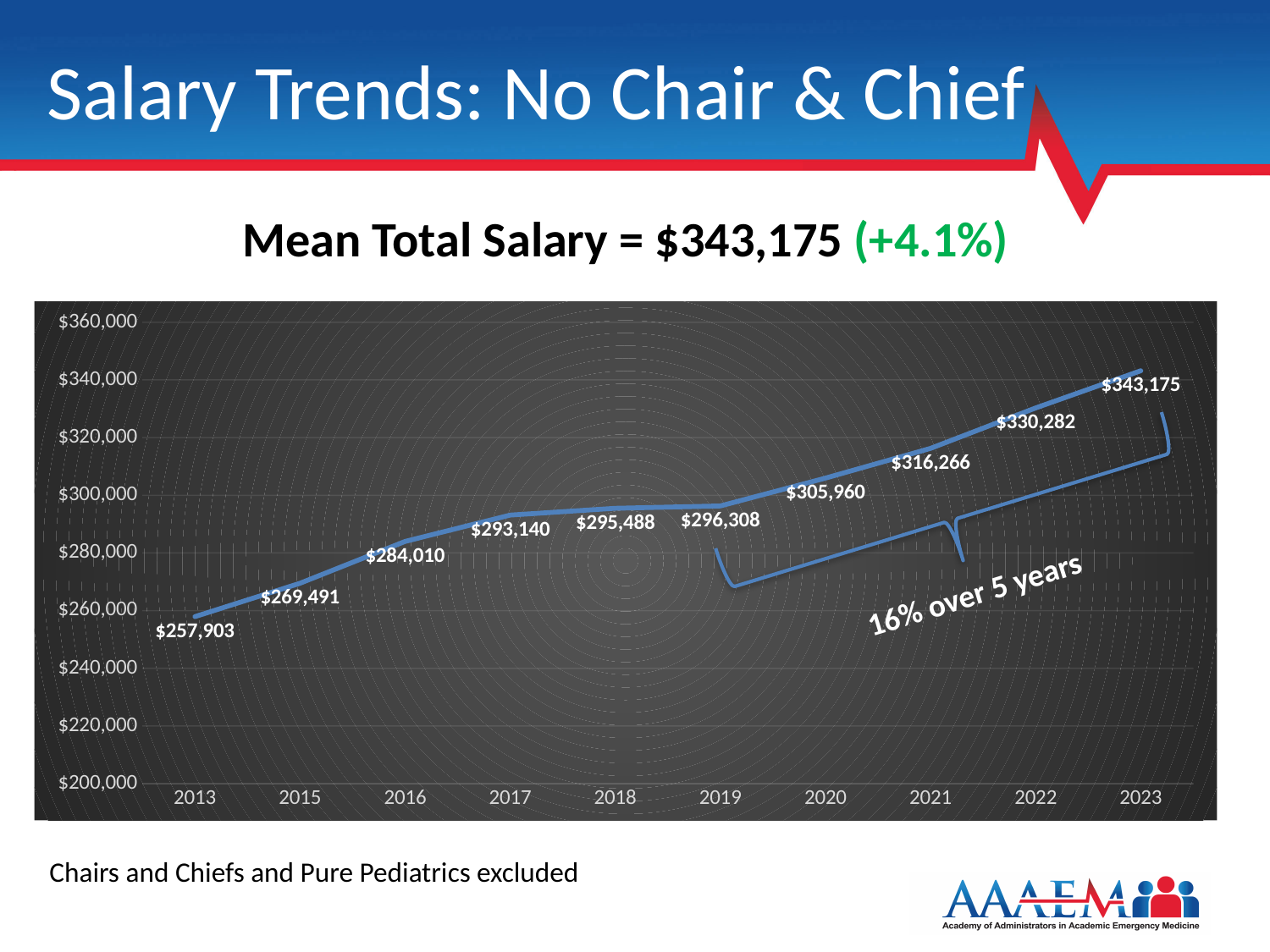
What is the mean total salary for 2021? $316,266 What is the mean total salary for 2013? $257,903 How many years are plotted on the x axis? 10 Which year has the lowest mean total salary? 2013 What is the difference between the 2023 and 2022 mean total salaries? $12,893 What is the mean total salary for 2019? $296,308 Do the mean total salary values rise or fall from 2013 to 2023? rise What kind of chart is shown? line chart What is the difference between the 2018 and 2017 mean total salaries? $2,348 What is the mean total salary for 2023? $343,175 Which year has the highest mean total salary? 2023 Which is larger, the mean total salary for 2016 or for 2015? 2016